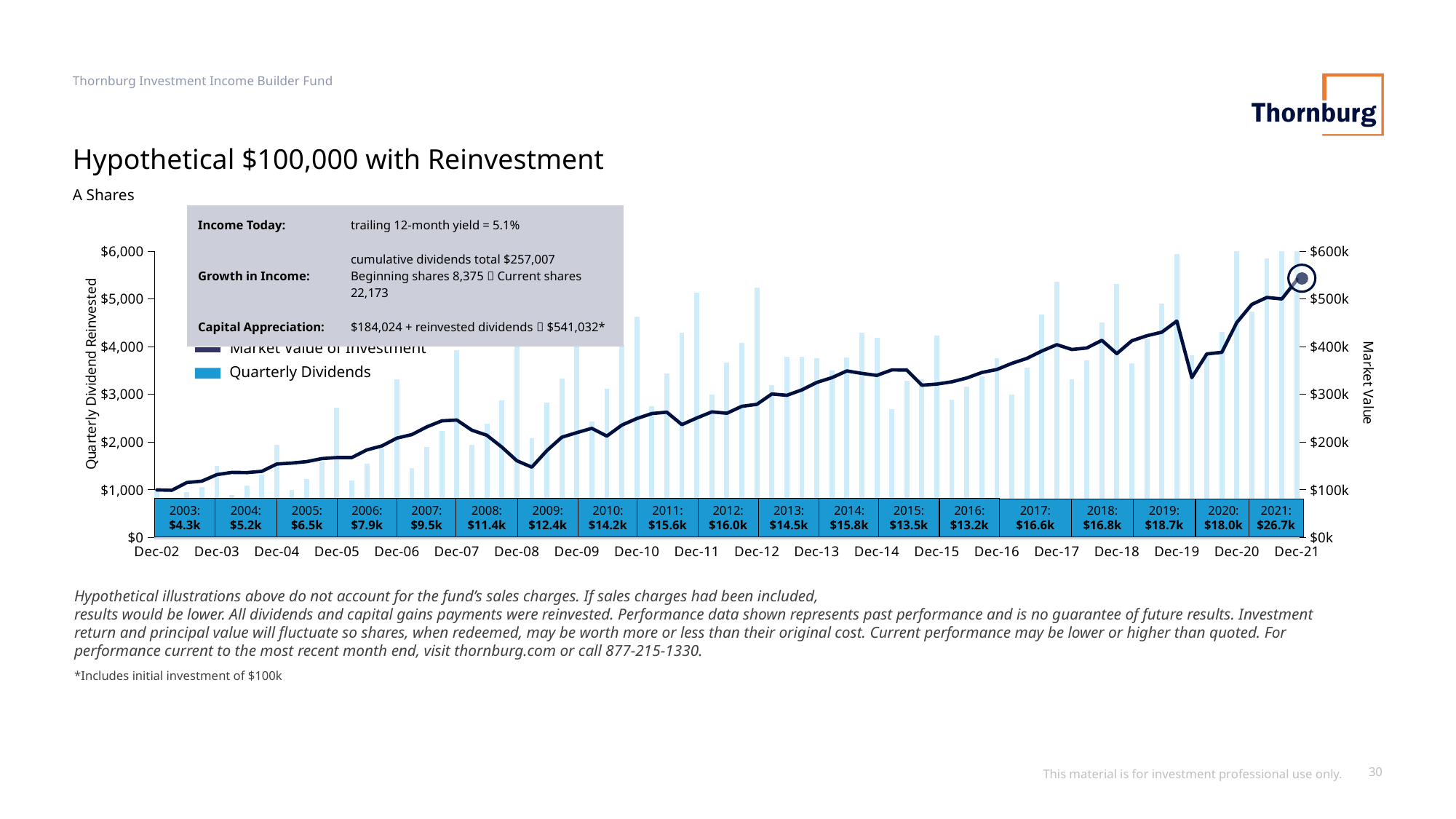
What is the annual dividend total shown for 2003? $4.3k Which year has the larger annual dividend total, 2015 or 2016? 2015 Does the Market Value of Investment line generally rise or fall from Dec-02 to Dec-21? rise How many annual dividend totals are labelled along the bottom of the chart? 19 Is the Market Value of Investment at Dec-21 greater or less than $500k? greater What is the difference between the annual dividend totals for 2021 and 2003? $22.4k Is the Market Value of Investment at Dec-08 greater or less than $200k? less How many series does the chart legend list? 2 Which year has the highest annual dividend total shown? 2021 Which year has the lowest annual dividend total shown? 2003 What kind of chart is shown on the slide? A combined bar and line chart What is the annual dividend total shown for 2021? $26.7k